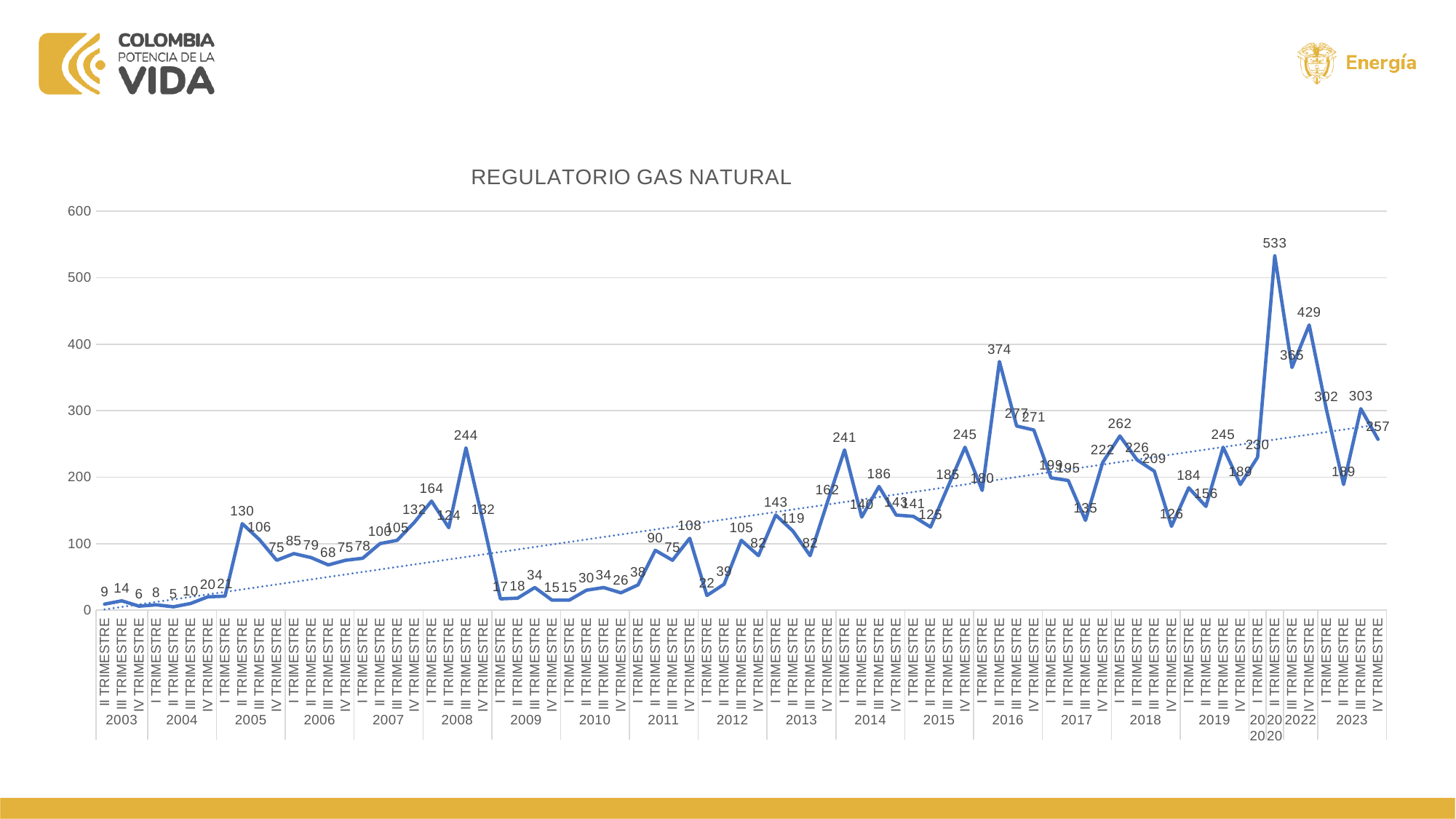
What is the lowest value plotted on the chart? 5 What is the value for II TRIMESTRE 2003, the first point on the chart? 9 What is the highest value plotted on the chart? 533 Overall, do the values rise or fall from 2003 to 2023? rise Is the value for II TRIMESTRE 2005 greater or less than 100? greater What is the value for III TRIMESTRE 2008? 244 Which is larger, the value for I TRIMESTRE 2018 or the value for IV TRIMESTRE 2017? I TRIMESTRE 2018 What is the title of the chart? REGULATORIO GAS NATURAL What is the value for IV TRIMESTRE 2023? 257 What is the difference between the value for II TRIMESTRE 2016 and the value for III TRIMESTRE 2008? 130 What is the value for II TRIMESTRE 2016? 374 What kind of chart is shown on the slide? line chart